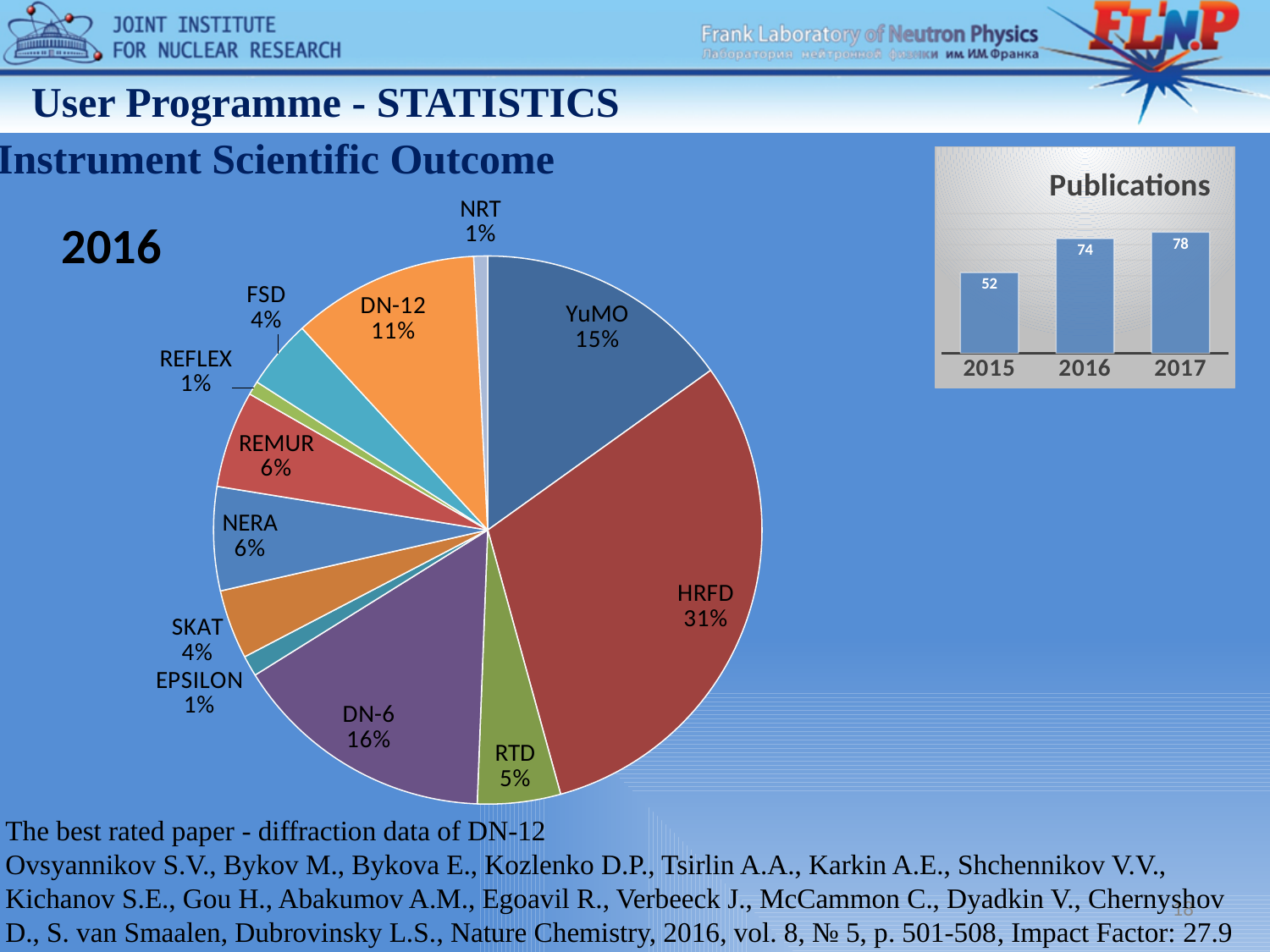
In the 2016 pie chart, which is larger, the share of YuMO or the share of DN-6? DN-6 In the Publications bar chart, which year has the highest number of publications? 2017 In the Publications bar chart, what is the difference between the number of publications in 2016 and 2015? 22 In the 2016 pie chart, what share does DN-12 have? 11% In the Publications bar chart, how many publications were there in 2017? 78 In the 2016 pie chart, what share does HRFD have? 31% In the Publications bar chart, which year has the lowest number of publications? 2015 In the 2016 pie chart, which instrument has the largest share? HRFD How many slices does the 2016 pie chart have? 12 What kind of chart is the Publications chart? bar chart In the Publications bar chart, how many publications were there in 2015? 52 In the Publications bar chart, do the values rise or fall from 2015 to 2017? rise